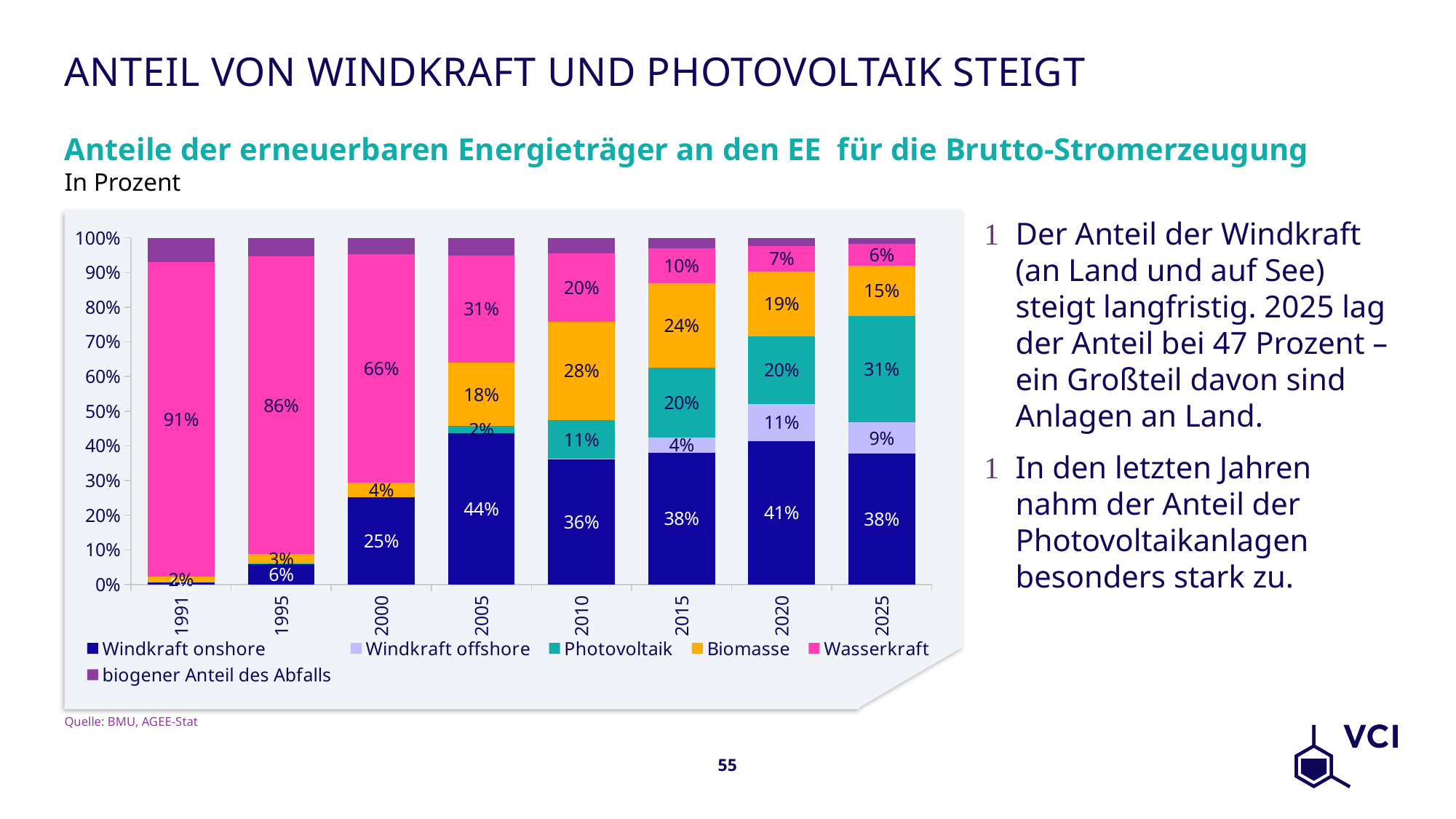
Which is larger in 2015: the Biomasse share or the Photovoltaik share? Biomasse How many series does the legend list? 6 What is the Windkraft offshore share in 2020? 11% How many years are shown on the x axis? 8 What is the Photovoltaik share in 2025? 31% What is the Biomasse share in 2010? 28% What is the combined share of Windkraft onshore and Windkraft offshore in 2025? 47% Does the Wasserkraft share rise or fall from 1991 to 2025? fall By how many percentage points did the Photovoltaik share change from 2020 to 2025? 11 percentage points In which year is the Wasserkraft share lowest? 2025 What share does Wasserkraft have in 1991? 91% In which year is the Windkraft onshore share highest? 2005